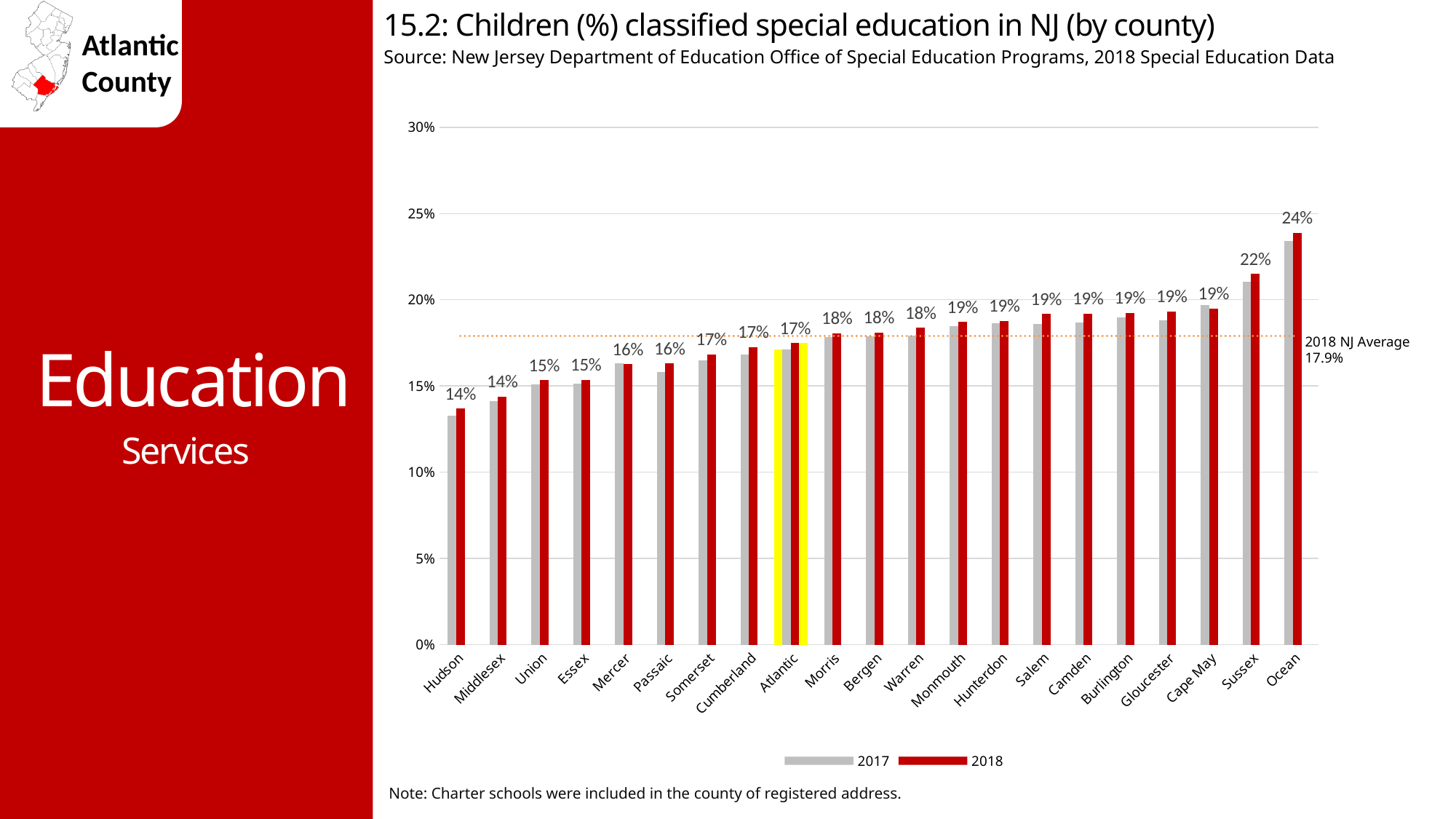
What is the difference between the 2018 values for Ocean and Hudson? 10% What is the 2018 value for Atlantic county? 17% What is the 2018 value for Sussex county? 22% Which county has the highest 2018 value? Ocean How many series does the legend list? 2 Is the 2017 value for Ocean greater or less than 20%? greater Is the 2017 value for Hudson greater or less than 15%? less What is the 2018 value for Ocean county? 24% How many counties are shown on the x axis? 21 What value does the dotted line labelled 2018 NJ Average represent? 17.9% What kind of chart is shown? bar chart Which has a larger 2018 value, Sussex or Cape May? Sussex